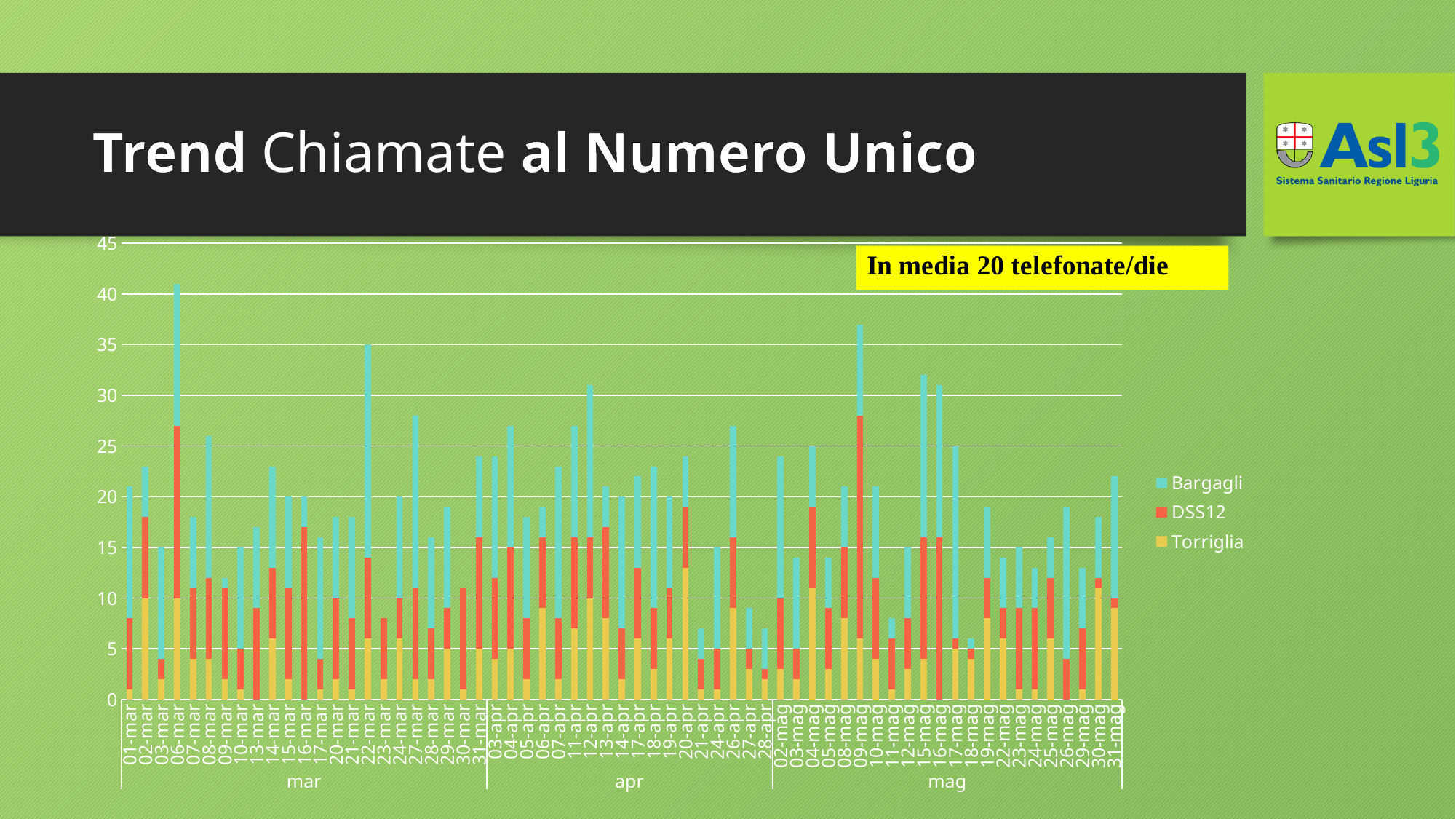
Is the total for 28-apr greater or less than 10? less How many months are shown along the x axis? 3 What average number of calls per day does the yellow note on the chart state? 20 telefonate/die What kind of chart is shown on the slide? stacked bar chart Which has the larger total, 06-mar or 09-mag? 06-mar Is the total for 22-mar greater or less than 30? greater Is the total for 09-mag greater or less than 30? greater Which date has the tallest stacked bar in the chart? 06-mar How many series does the legend list? 3 What is the title of the slide? Trend Chiamate al Numero Unico Which has the larger total, 22-mar or 12-apr? 22-mar